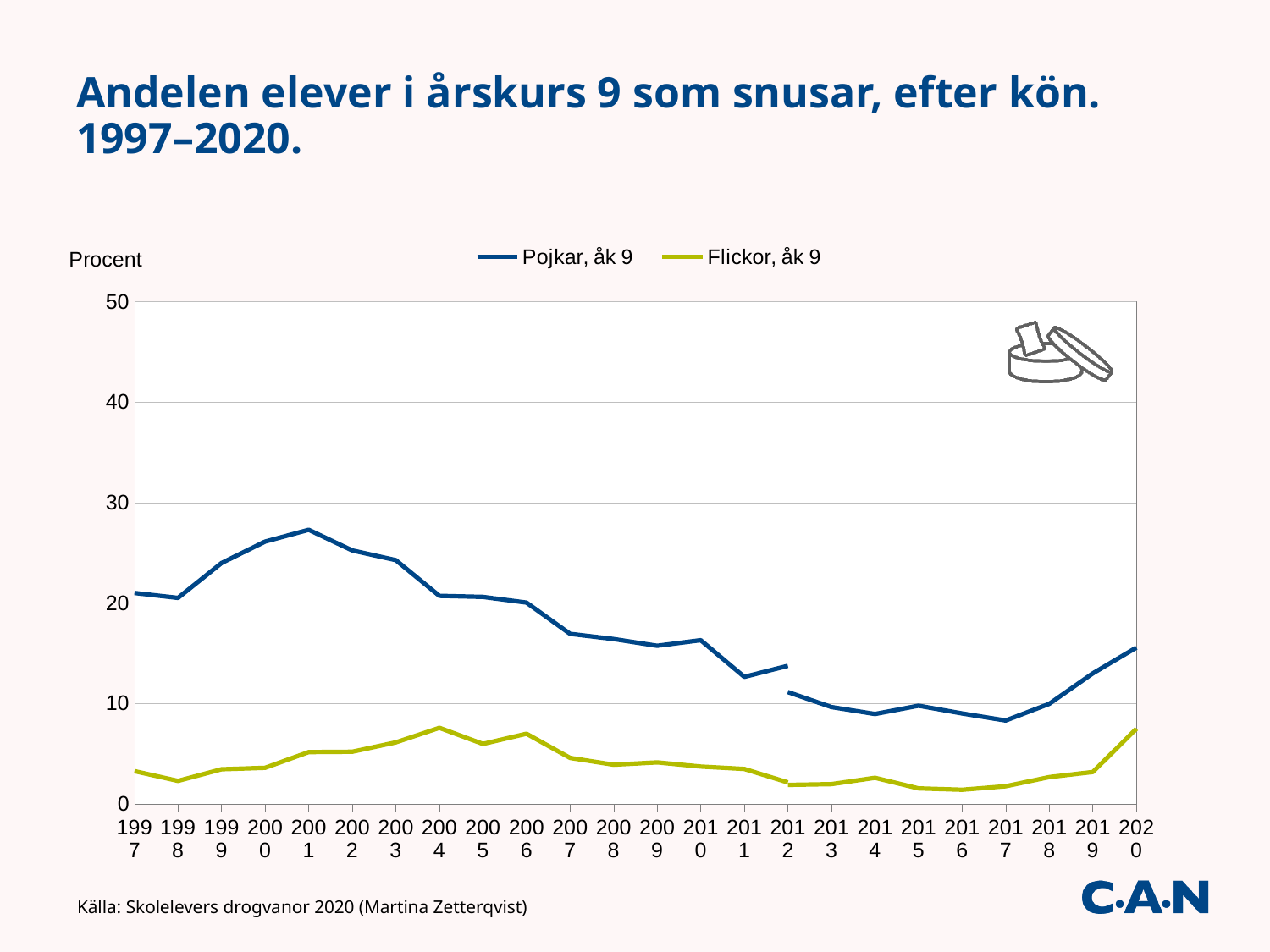
Does the Pojkar, åk 9 series rise or fall between 2017 and 2020? Rise How many series does the legend list? 2 Which series has the higher value in 2010, Pojkar, åk 9 or Flickor, åk 9? Pojkar, åk 9 In which year does the Pojkar, åk 9 series reach its lowest value? 2017 What is the label on the y axis? Procent Which two series are listed in the legend? Pojkar, åk 9 and Flickor, åk 9 Is the value for Pojkar, åk 9 in 2001 greater or less than 20? greater Is the value for Flickor, åk 9 in 2004 greater or less than 10? less Is the value for Pojkar, åk 9 in 2017 greater or less than 10? less What kind of chart is shown on the slide? Line chart In which year does the Pojkar, åk 9 series reach its highest value? 2001 How many years are plotted along the x axis? 24